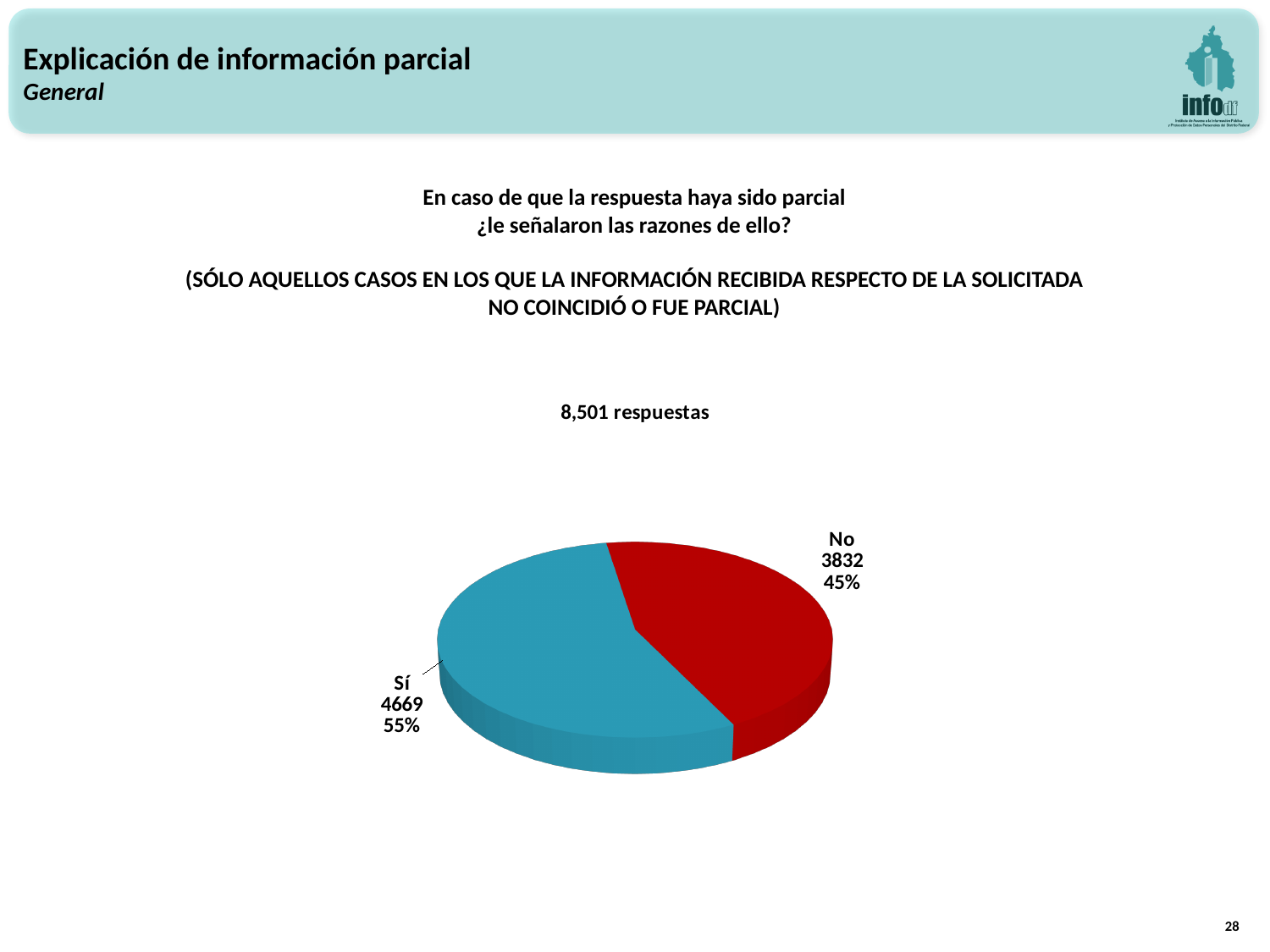
What percentage share does the "Sí" slice represent? 55% Which slice is the smallest? No What type of chart is shown on the slide? pie chart Which is larger, the value for "Sí" or the value for "No"? Sí What colour is the "No" slice? red Which slice is the largest? Sí How many slices does the pie chart have? 2 How many total responses does the slide state the chart is based on? 8,501 respuestas What is the value for the "No" slice? 3832 What is the value for the "Sí" slice? 4669 What percentage share does the "No" slice represent? 45% What is the difference between the "Sí" and "No" values? 837